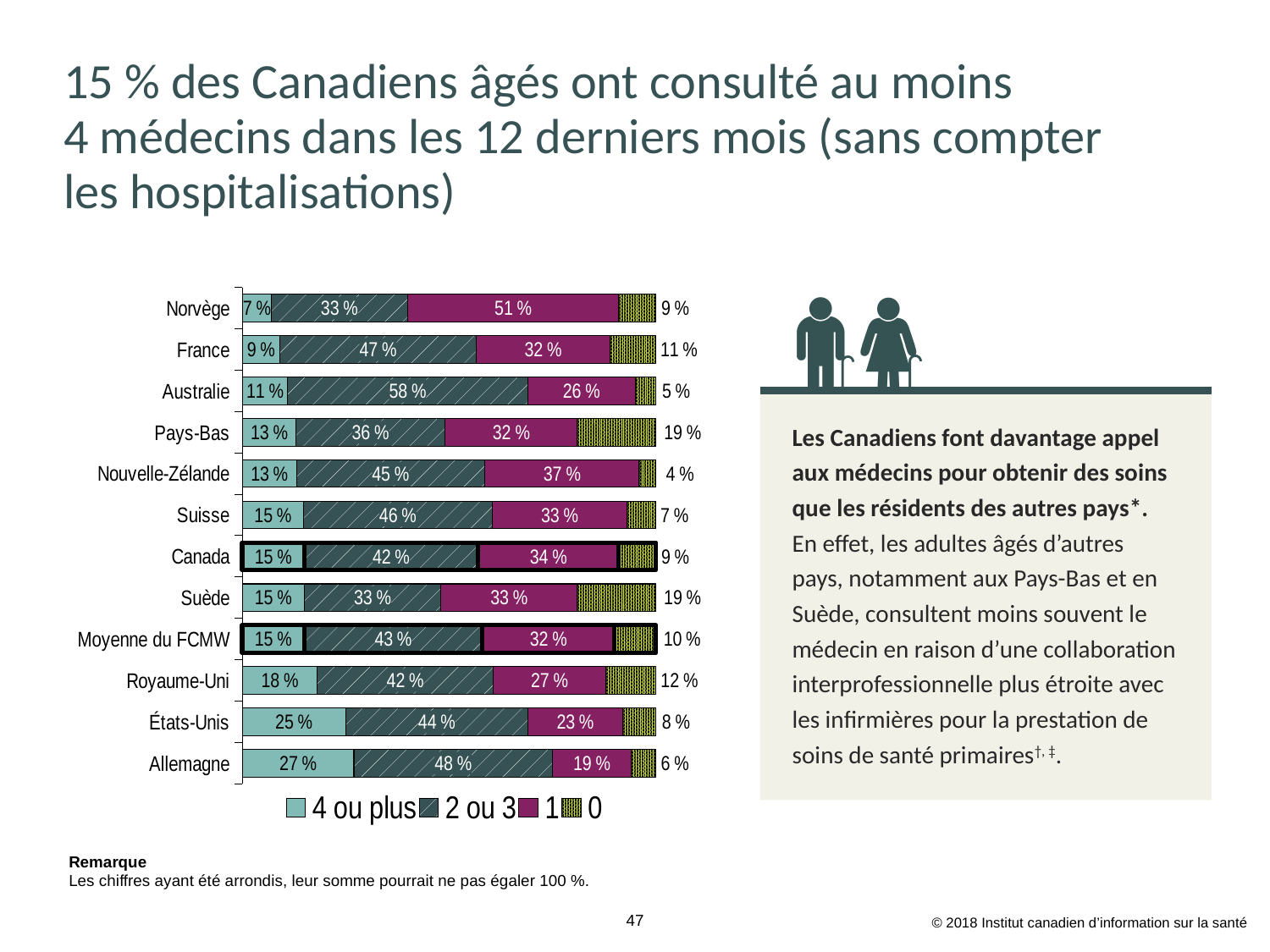
Which country has the highest value for "4 ou plus"? Allemagne What are the four legend entries of the chart? 4 ou plus, 2 ou 3, 1, 0 Which country has the lowest value for "4 ou plus"? Norvège How many series does the legend list? 4 What type of chart is shown on the slide? Stacked bar chart Which has a larger "2 ou 3" value, France or Suède? France What is the value for "2 ou 3" for Australie? 58 % What is the value for "4 ou plus" for Canada? 15 % What is the value for "0" for Pays-Bas? 19 % What is the difference between the "4 ou plus" values for États-Unis and Canada? 10 % How many countries or categories are listed on the chart? 12 Which country has the highest value for "1"? Norvège